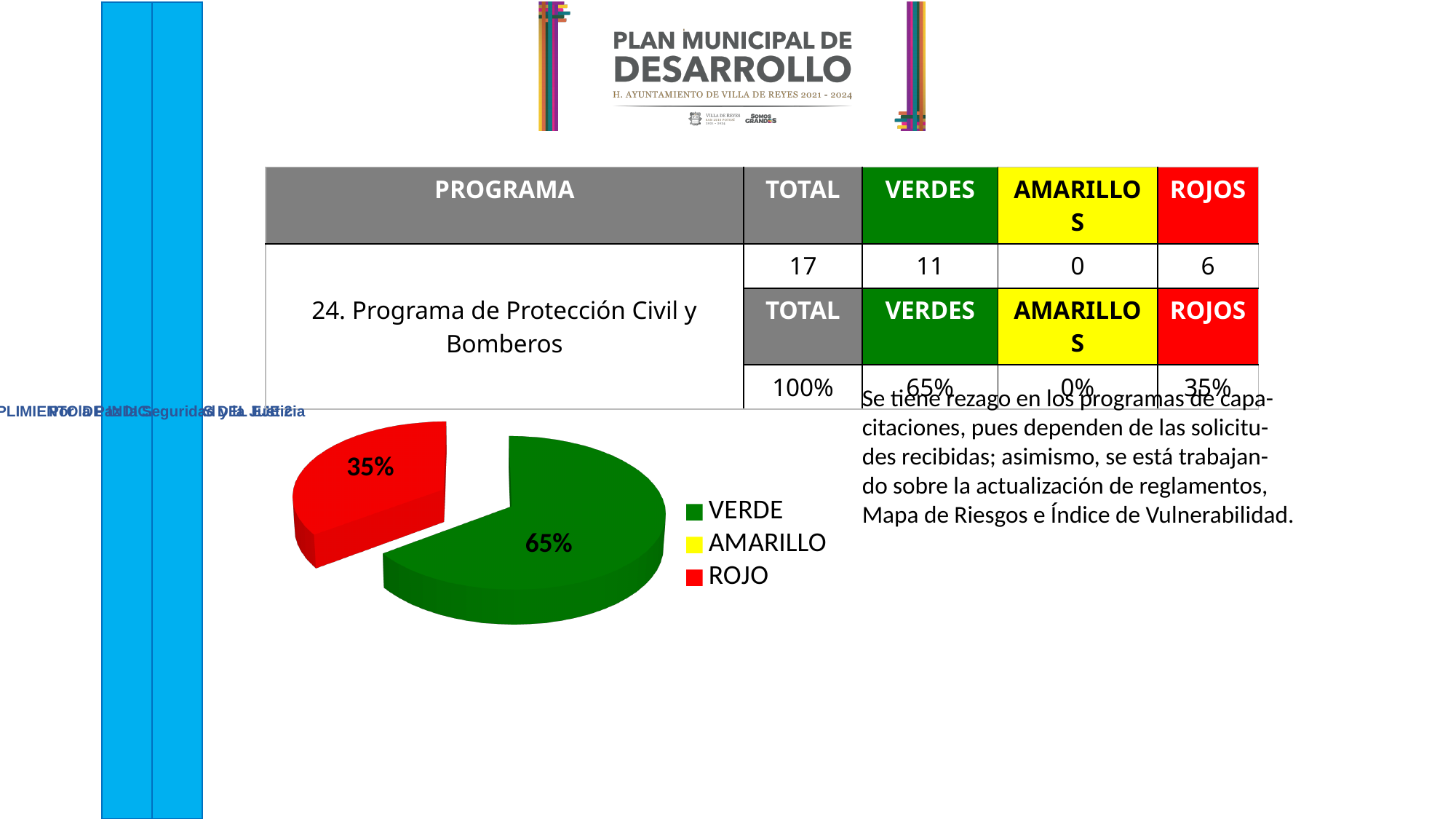
Which category has the largest slice of the pie? VERDE What kind of chart is shown on the slide? pie chart What colour is used for the ROJO slice in the pie chart? red How many slices are visible in the pie chart? 2 Which legend entry has no visible slice in the pie chart? AMARILLO How many entries does the legend list? 3 Which is larger, the VERDE slice or the ROJO slice? VERDE What share of the pie does ROJO represent? 35% What is the difference in percentage points between the VERDE and ROJO slices? 30 What share of the pie does VERDE represent? 65%